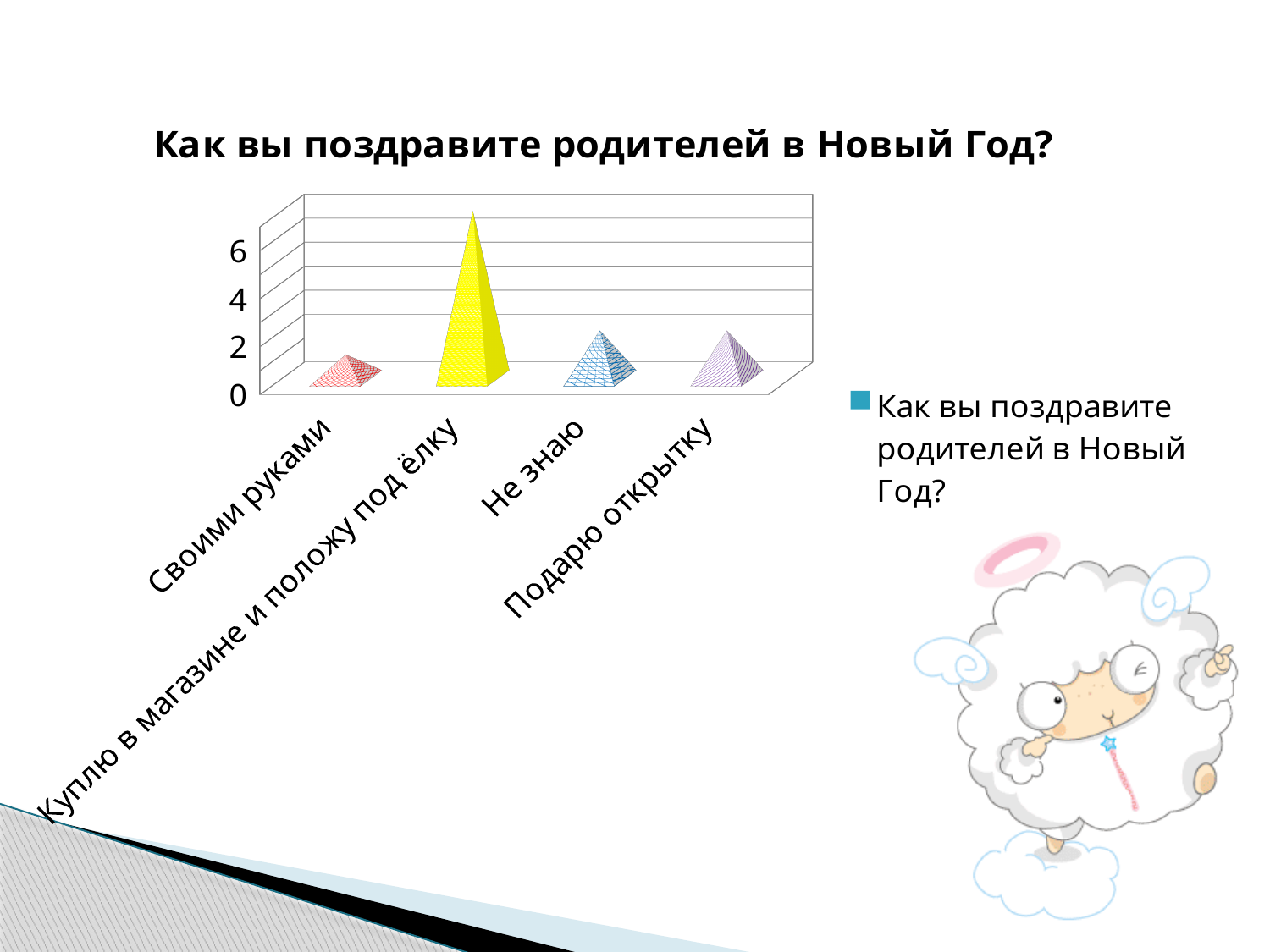
Is the value for "Подарю открытку" greater or less than 4? less Which category has the highest value in the chart? Куплю в магазине и положу под ёлку Is the value for "Не знаю" greater or less than 4? less Which is larger: the value for "Куплю в магазине и положу под ёлку" or the value for "Не знаю"? Куплю в магазине и положу под ёлку What is the title of the chart on the slide? Как вы поздравите родителей в Новый Год? What kind of chart is shown on the slide? bar chart Which category has the lowest value in the chart? Своими руками Is the value for "Куплю в магазине и положу под ёлку" greater or less than 6? greater Which is larger: the value for "Подарю открытку" or the value for "Своими руками"? Подарю открытку What is the highest tick value shown on the vertical axis of the chart? 6 How many categories are shown on the x axis of the chart? 4